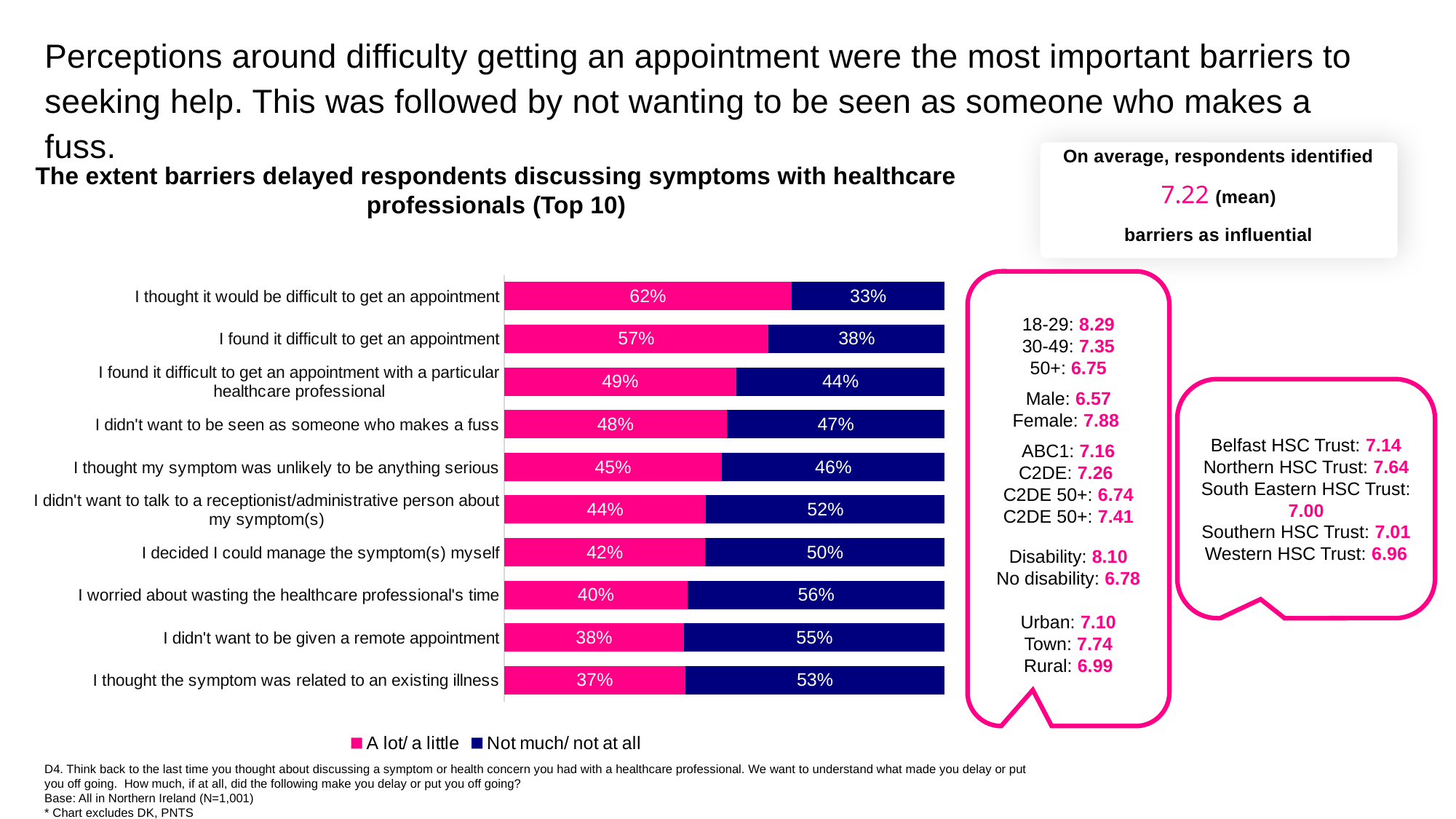
What is the total of the two segments for 'I didn't want to talk to a receptionist/administrative person about my symptom(s)'? 96% How many barriers are shown in the chart? 10 What percentage of respondents said 'I thought it would be difficult to get an appointment' delayed them a lot/a little? 62% Which barrier has the lowest 'A lot/ a little' percentage? I thought the symptom was related to an existing illness What is the 'A lot/ a little' value for 'I worried about wasting the healthcare professional's time'? 40% What kind of chart is shown on the slide? Stacked bar chart What is the difference between the 'A lot/ a little' values for 'I found it difficult to get an appointment' and 'I didn't want to be given a remote appointment'? 19 percentage points Which barrier has the highest 'A lot/ a little' percentage? I thought it would be difficult to get an appointment Which colour represents 'A lot/ a little' in the chart? Pink What is the 'Not much/ not at all' value for 'I didn't want to be seen as someone who makes a fuss'? 47% How many series does the legend list? 2 Which is larger: the 'Not much/ not at all' value for 'I decided I could manage the symptom(s) myself' or for 'I thought my symptom was unlikely to be anything serious'? I decided I could manage the symptom(s) myself